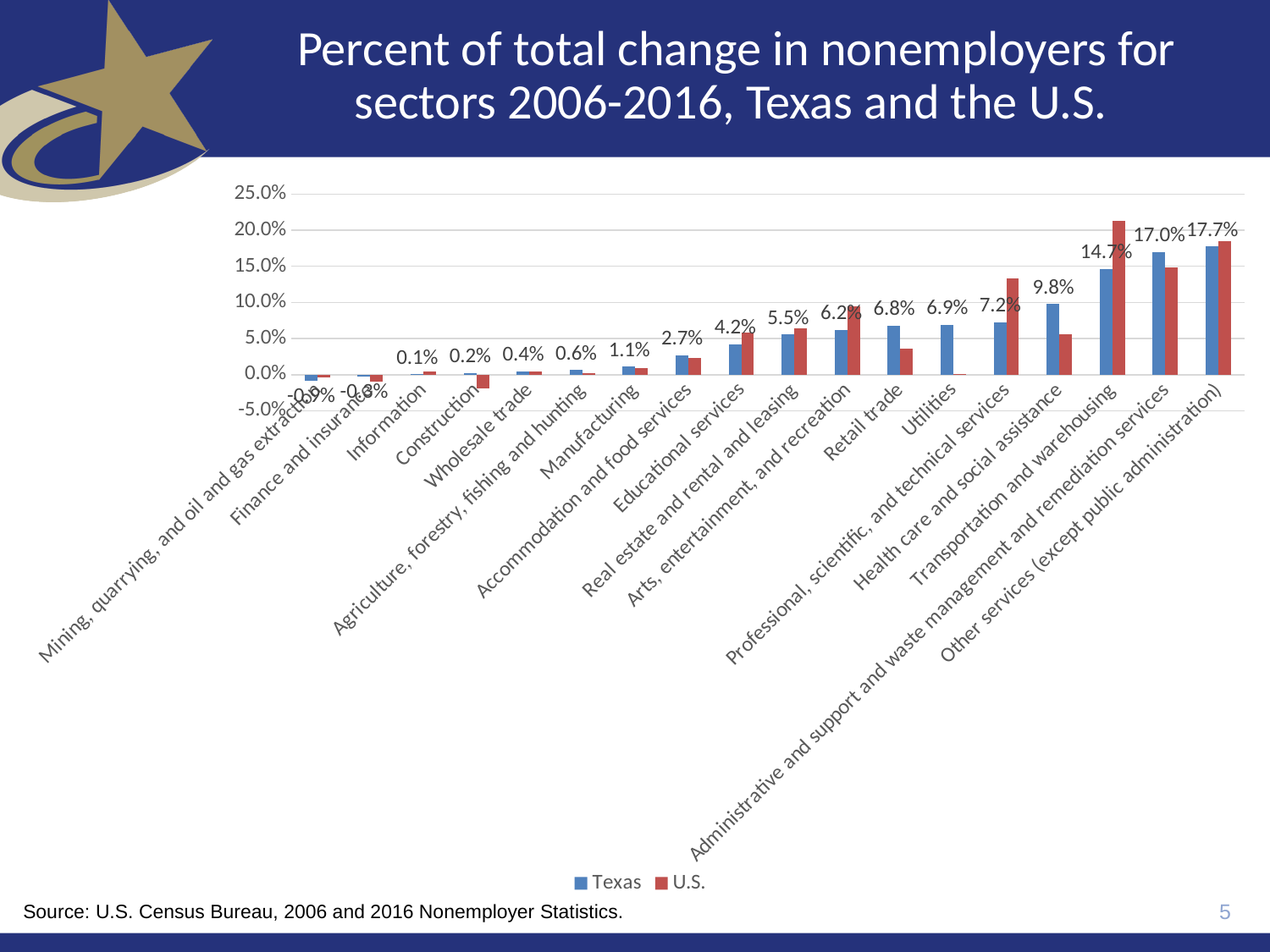
What is the Texas value for Manufacturing? 1.1% What is the difference between the Texas values for Other services (except public administration) and Administrative and support and waste management and remediation services? 0.7% What is the Texas value for Health care and social assistance? 9.8% For Utilities, which is larger, the Texas value or the U.S. value? Texas Which sector has the highest Texas value? Other services (except public administration) What is the Texas value for Transportation and warehousing? 14.7% Which sector has the lowest Texas value? Mining, quarrying, and oil and gas extraction Is the U.S. value for Transportation and warehousing greater or less than 20.0%? greater What is the Texas value for Educational services? 4.2% How many series does the legend list? 2 How many sectors are shown on the x axis? 18 For Transportation and warehousing, which is larger, the Texas value or the U.S. value? U.S.